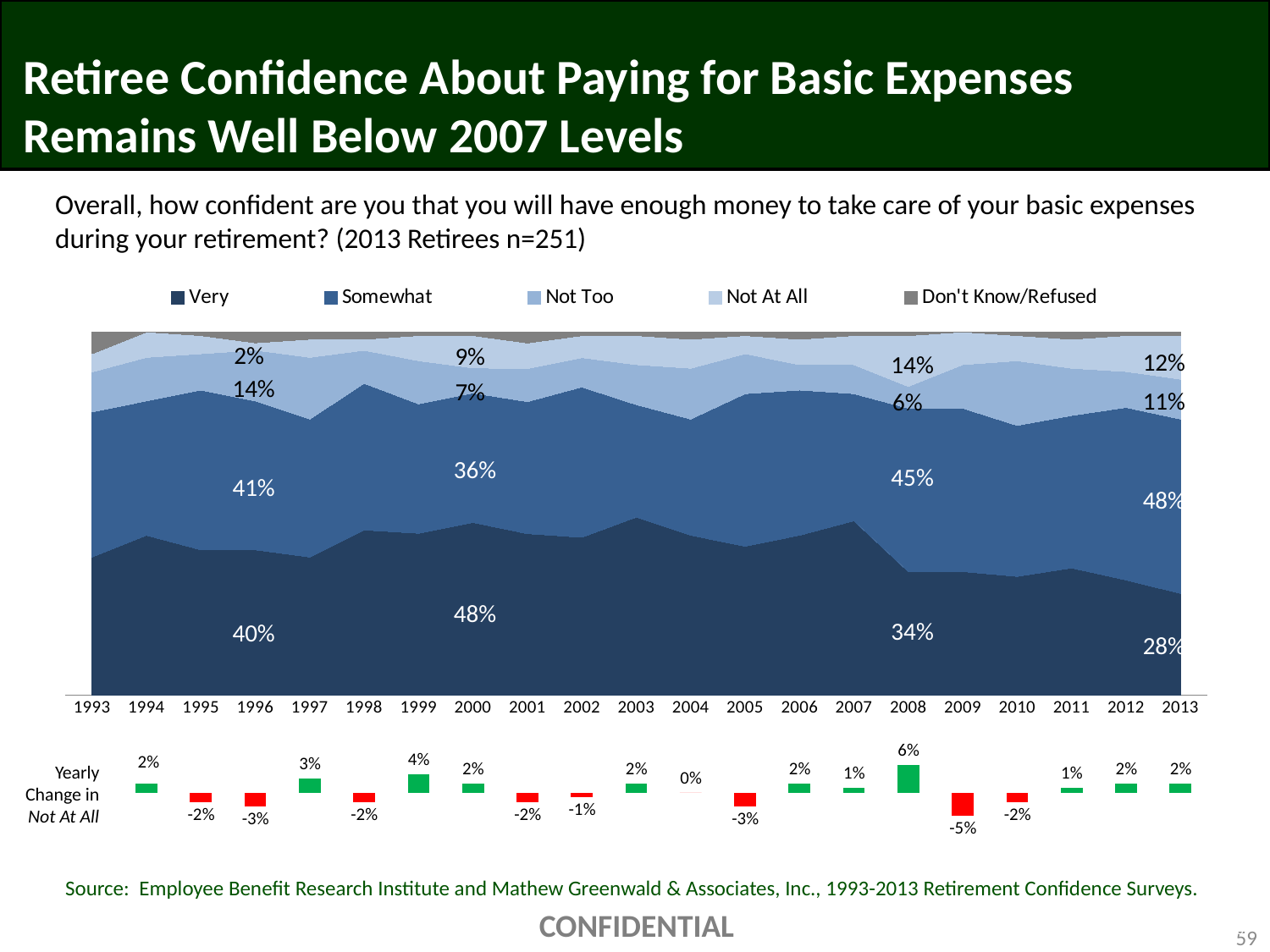
How many years are shown on the x axis of the stacked area chart? 21 In the stacked area chart, what is the "Not Too" value labelled for 1996? 14% In the stacked area chart, what is the "Not At All" value labelled for 2008? 14% In the "Yearly Change in Not At All" bar chart, what is the value for 2004? 0% In the stacked area chart, which is larger in 2008: the "Very" share or the "Somewhat" share? Somewhat In the stacked area chart, what percentage of retirees were "Very" confident in 2000? 48% How many series does the legend of the stacked area chart list? 5 What kind of chart is the main chart showing confidence levels from 1993 to 2013? Stacked area chart In the "Yearly Change in Not At All" bar chart, which year has the largest decrease? 2009 In the stacked area chart, by how many percentage points did the "Very" confident share fall between 2000 and 2013? 20 percentage points In the stacked area chart, what percentage of retirees were "Somewhat" confident in 2013? 48% In the "Yearly Change in Not At All" bar chart, which year has the largest increase? 2008